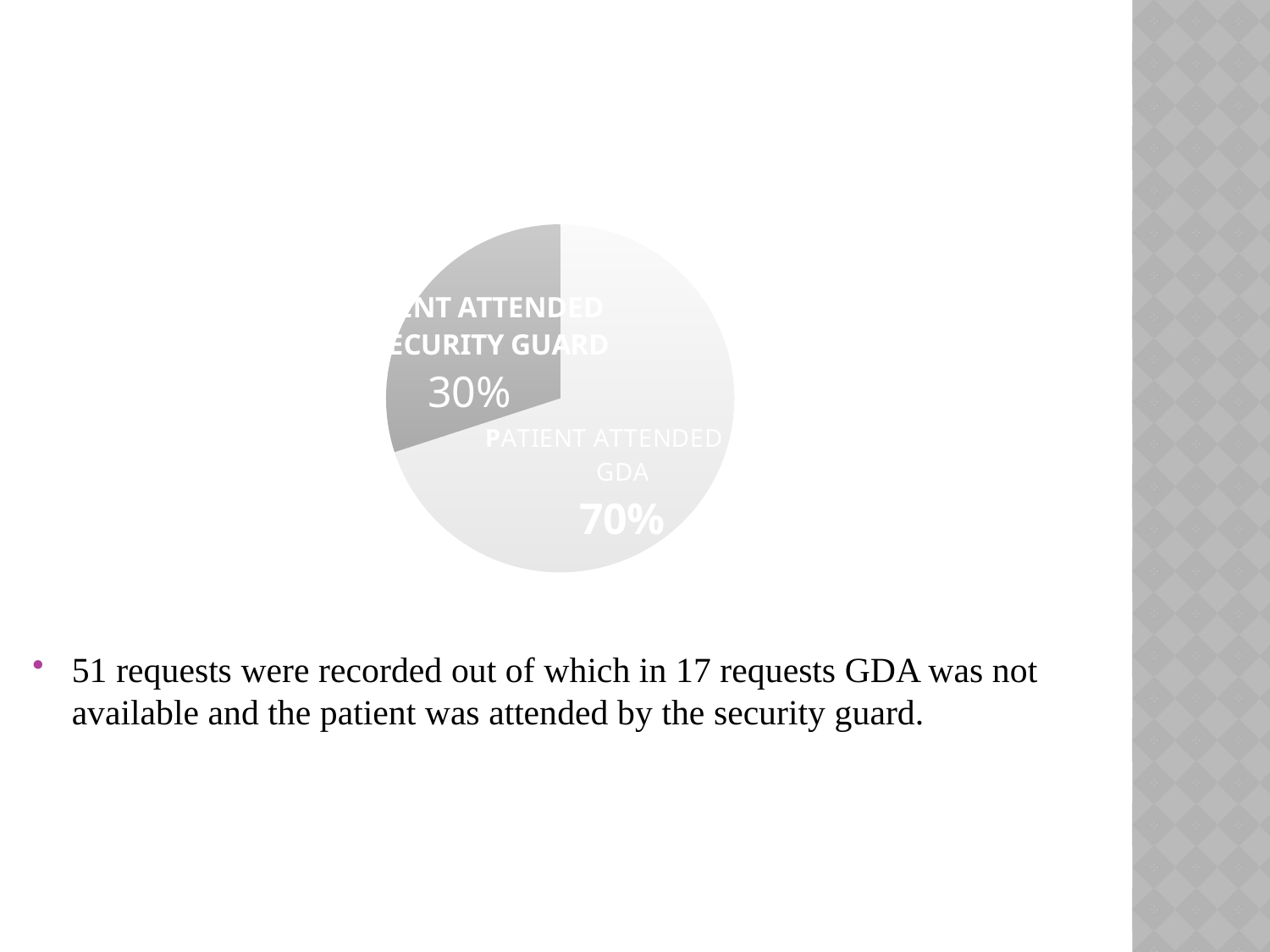
Which slice of the pie chart is the largest? PATIENT ATTENDED GDA By how many percentage points does the PATIENT ATTENDED GDA slice exceed the PATIENT ATTENDED SECURITY GUARD slice? 40 percentage points What share of the pie does the PATIENT ATTENDED GDA slice represent? 70% What percentage is shown for the PATIENT ATTENDED SECURITY GUARD slice? 30% Do the two slice percentages in the pie chart add up to 100%? Yes Which slice of the pie chart is the smallest? PATIENT ATTENDED SECURITY GUARD Which slice of the pie chart is shaded in the darker grey? PATIENT ATTENDED SECURITY GUARD Which is larger: the PATIENT ATTENDED GDA slice or the PATIENT ATTENDED SECURITY GUARD slice? PATIENT ATTENDED GDA What share of the pie chart is labelled PATIENT ATTENDED GDA? 70% Is the PATIENT ATTENDED SECURITY GUARD slice greater or less than 50% of the pie? less What kind of chart is shown on the slide? Pie chart How many slices does the pie chart have? 2